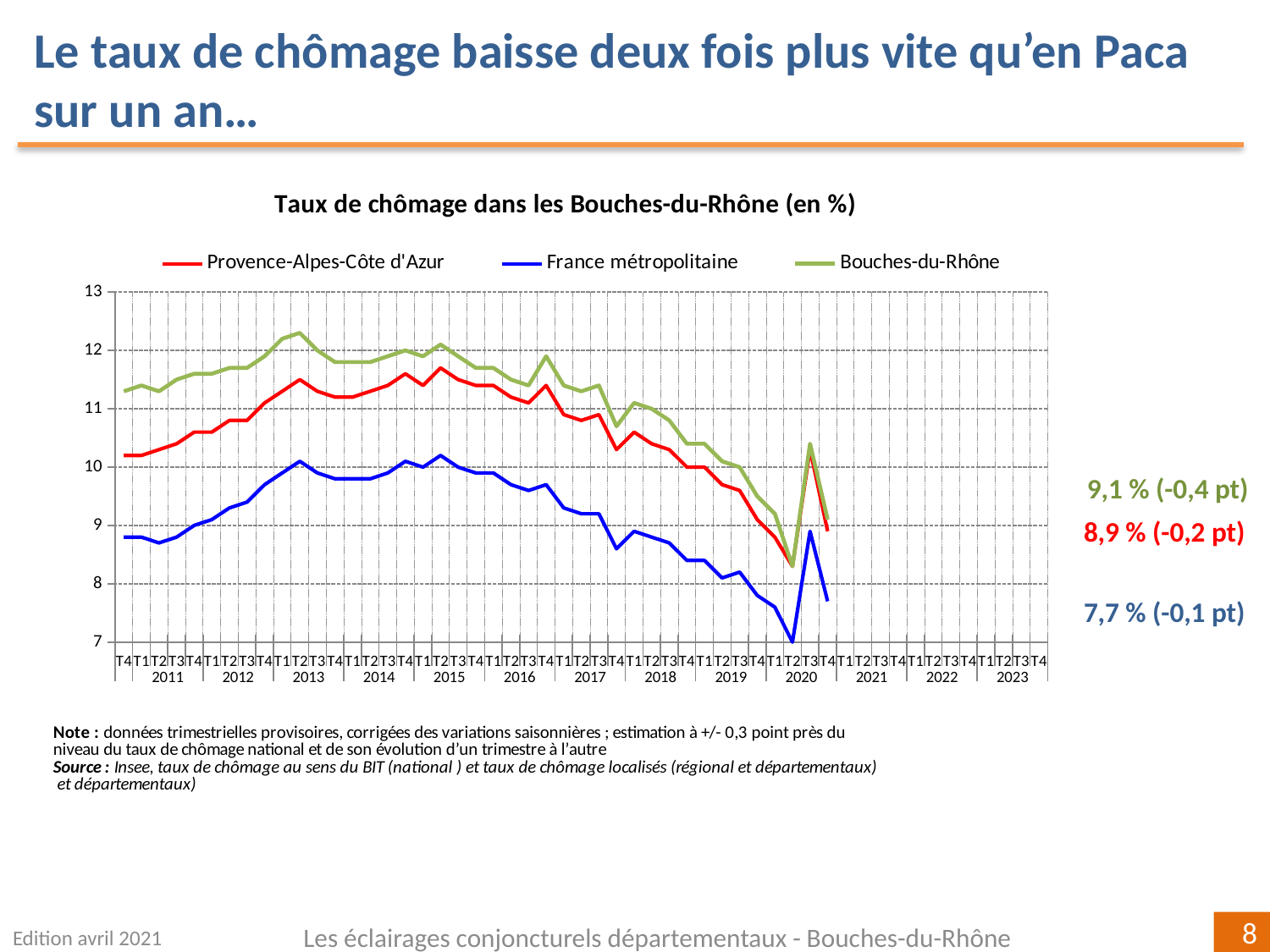
How many series does the legend of the chart list? 3 What type of chart is shown on the slide? Line chart Is the value for Bouches-du-Rhône at T2 2013 greater or less than 12? greater Which series reaches the highest value on the chart? Bouches-du-Rhône What is the latest unemployment rate shown for Provence-Alpes-Côte d'Azur? 8,9 % What is the latest unemployment rate shown for Bouches-du-Rhône? 9,1 % By how many points did the Bouches-du-Rhône unemployment rate change over one year, according to the annotation? -0,4 pt Is the value for Provence-Alpes-Côte d'Azur at T2 2020 greater or less than 9? less What is the title of the chart? Taux de chômage dans les Bouches-du-Rhône (en %) What is the difference between the latest rates for Bouches-du-Rhône and France métropolitaine? 1,4 points What is the latest unemployment rate shown for France métropolitaine? 7,7 % Which series has the lowest values throughout the period shown? France métropolitaine